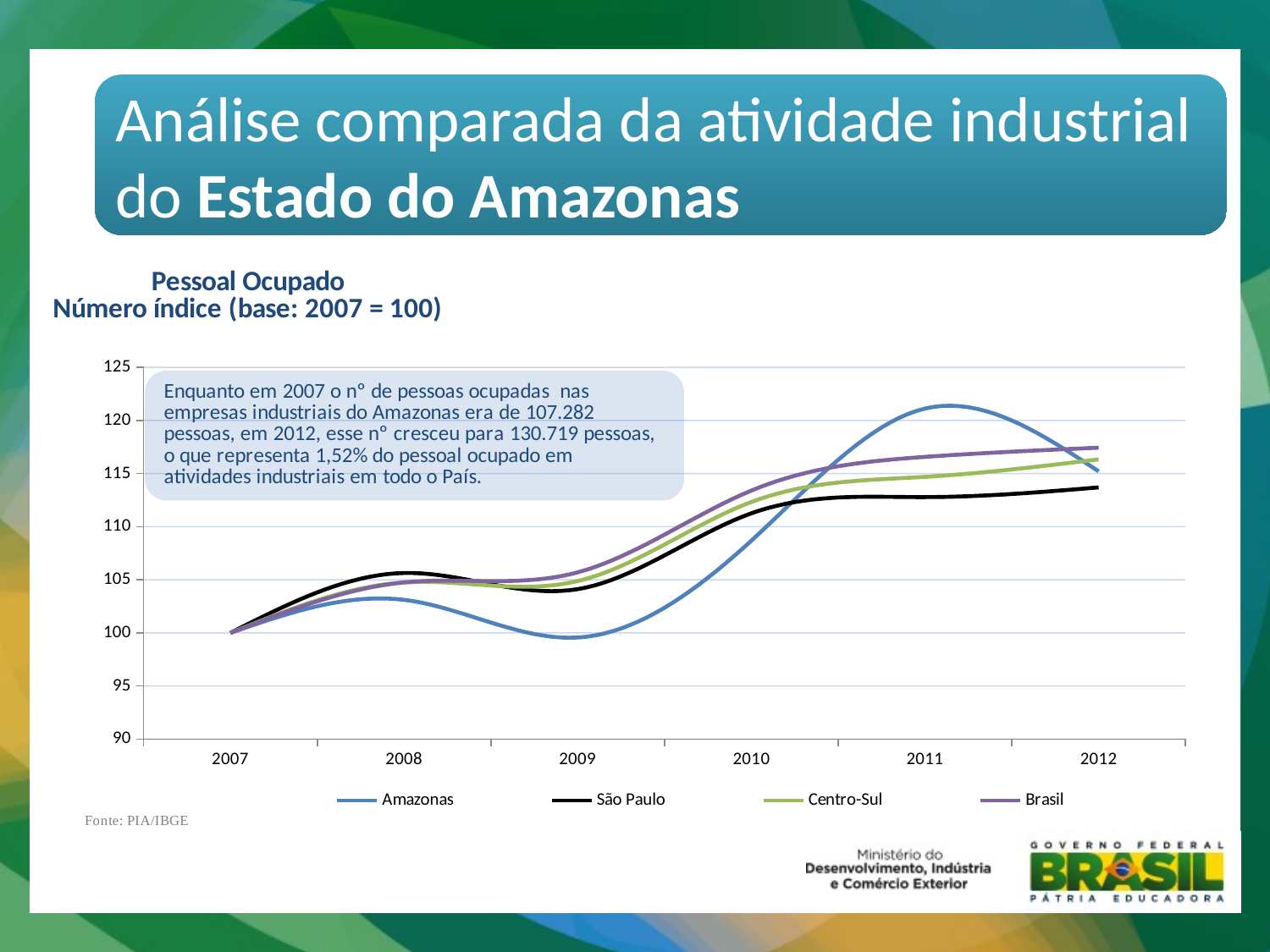
What source is cited below the chart? PIA/IBGE Which series has the highest value in 2011? Amazonas Which series has the lowest value in 2009? Amazonas Is the value for Brasil in 2010 greater or less than 110? greater How many series does the chart legend list? 4 Is the value for Amazonas in 2008 greater or less than 105? less Is the value for São Paulo in 2012 greater or less than 115? less Does the Amazonas series rise or fall between 2009 and 2011? rise In 2012, which series has the larger value, Brasil or São Paulo? Brasil How many years are shown on the x axis of the chart? 6 What is the index value for all series in 2007, the base year? 100 What kind of chart is shown on the slide? line chart